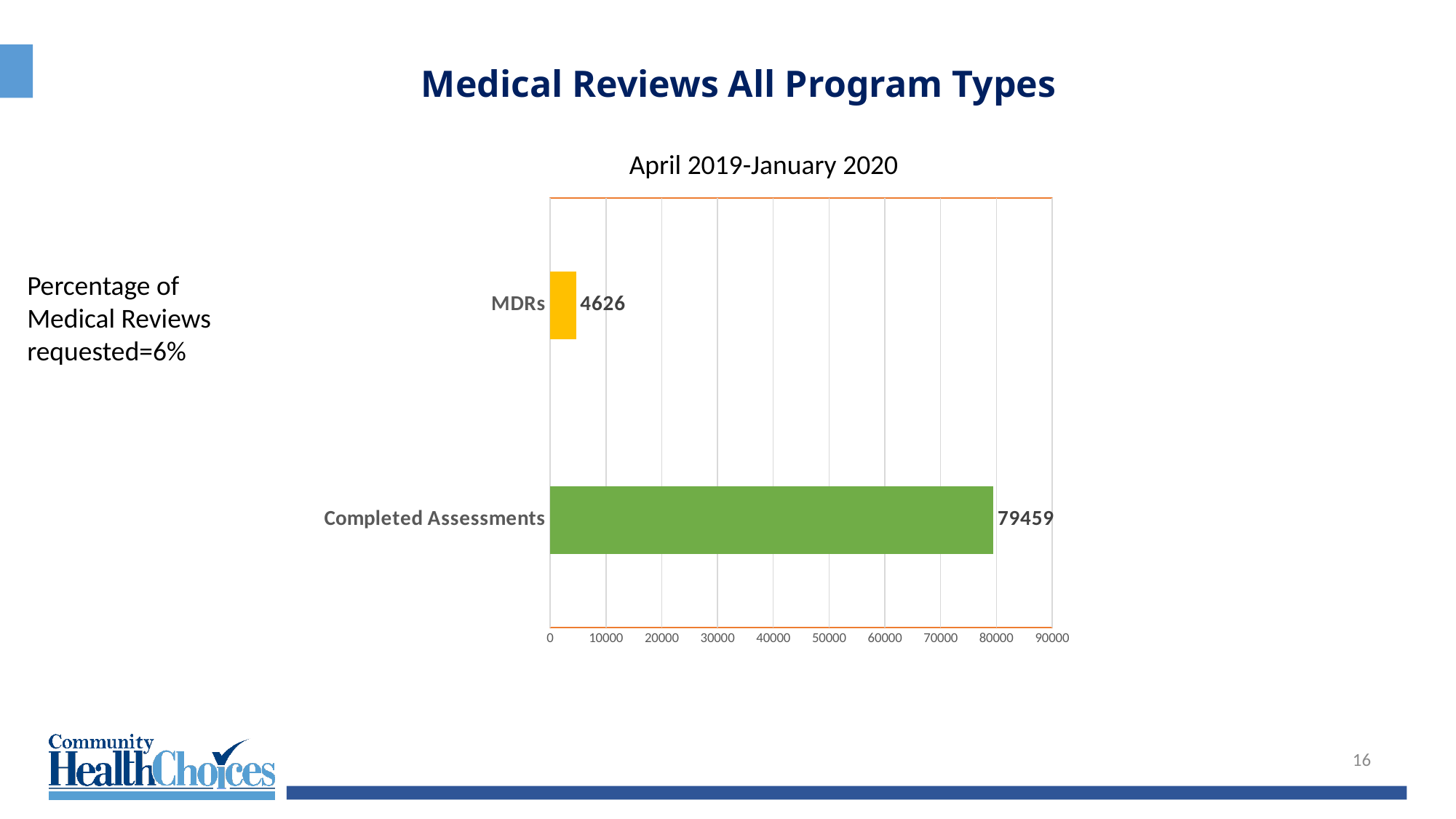
What is the value for MDRs? 4626 What colour is the bar for Completed Assessments? green Which category has the lowest value? MDRs Which is larger, the value for MDRs or the value for Completed Assessments? Completed Assessments How many categories are shown in the chart? 2 What is the value for Completed Assessments? 79459 What is the title of the chart? April 2019-January 2020 What is the difference between Completed Assessments and MDRs? 74833 Which category has the highest value? Completed Assessments Is the value for Completed Assessments greater or less than 70000? greater Is the value for MDRs greater or less than 10000? less What kind of chart is shown on the slide? bar chart